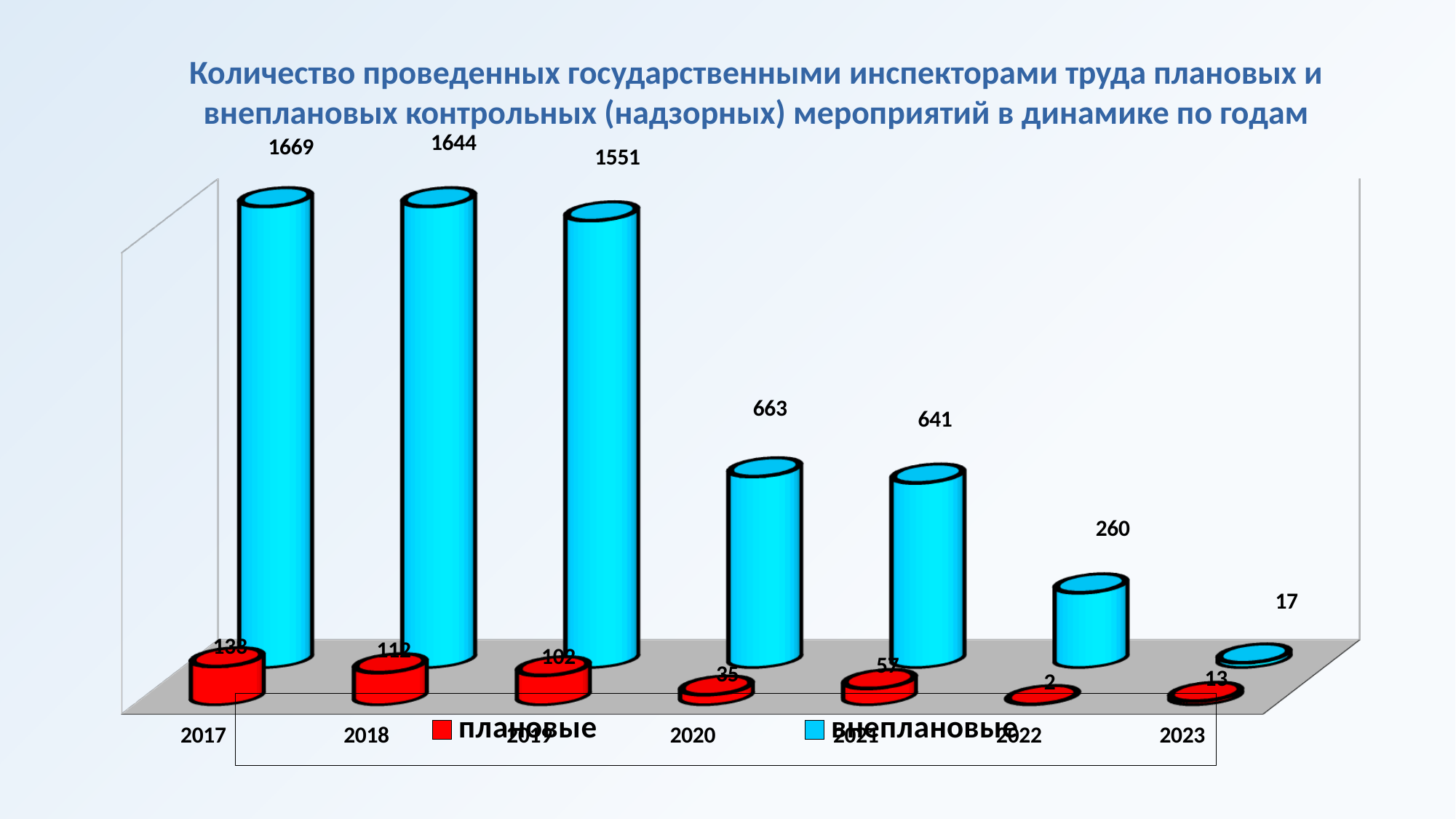
What is the value of плановые for 2019? 102 Which year has a larger внеплановые value, 2019 or 2020? 2019 How many series does the legend list? 2 Do the внеплановые values rise or fall from 2017 to 2023? fall What is the value of внеплановые for 2020? 663 What is the difference between the внеплановые values for 2020 and 2021? 22 What is the difference between the внеплановые values for 2017 and 2018? 25 In which year is the value of внеплановые the highest? 2017 What is the value of внеплановые for 2023? 17 How many years are shown on the x axis? 7 What is the value of внеплановые for 2017? 1669 In which year is the value of внеплановые the lowest? 2023